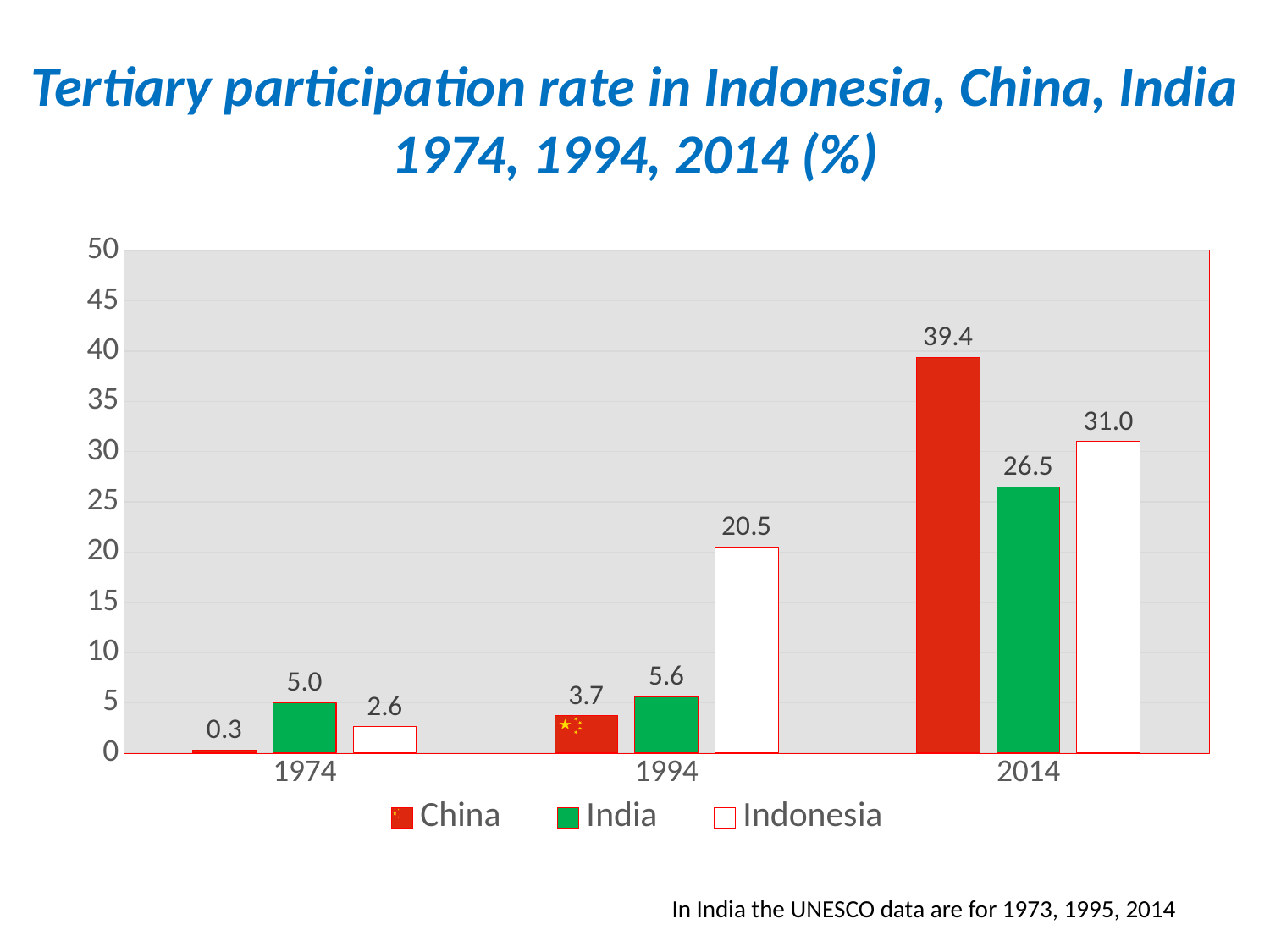
What is the difference between Indonesia's and India's tertiary participation rates in 2014? 4.5 What is the tertiary participation rate for Indonesia in 1994? 20.5 How many series does the legend list? 3 Is the value for Indonesia in 2014 greater or less than 30? greater What is the tertiary participation rate for India in 1974? 5.0 In 1994, which is larger: the rate for India or the rate for China? India Which country has the lowest tertiary participation rate in 1974? China How many years are shown on the x axis? 3 Does China's tertiary participation rate rise or fall from 1974 to 2014? Rise Which country has the highest tertiary participation rate in 2014? China What is the tertiary participation rate for China in 2014? 39.4 What kind of chart is shown on the slide? Bar chart